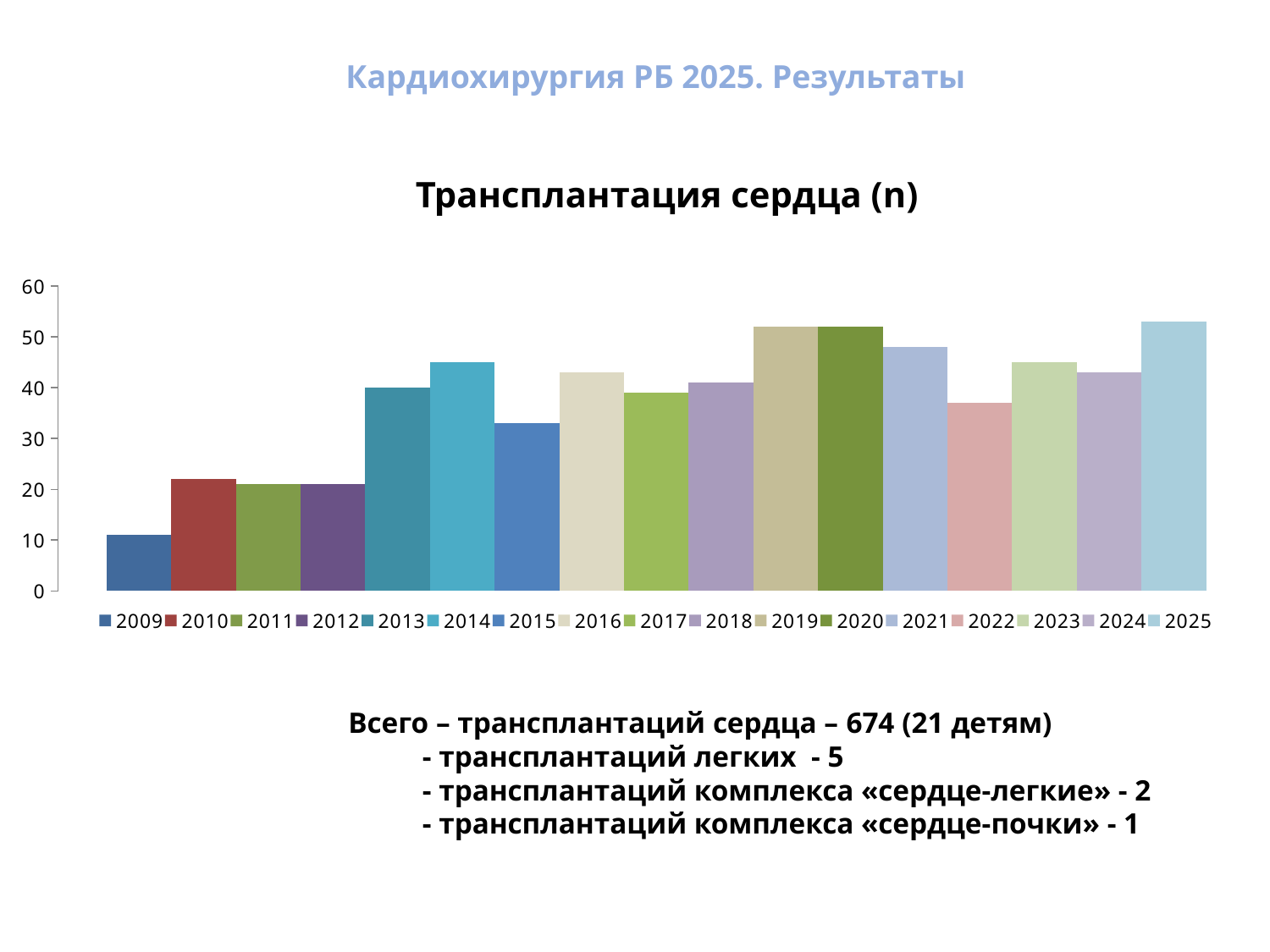
What kind of chart is shown on the slide? bar chart How many years (bars) are shown in the chart? 17 Do the values generally rise or fall from 2009 to 2014? rise Is the value for 2025 greater or less than 50? greater What is the title of the chart? Трансплантация сердца (n) Which year has the lowest number of heart transplants in the chart? 2009 Is the value for 2021 greater or less than 40? greater How many entries does the legend list? 17 Which is larger, the value for 2014 or the value for 2015? 2014 Is the value for 2022 greater or less than 40? less Which is larger, the value for 2019 or the value for 2022? 2019